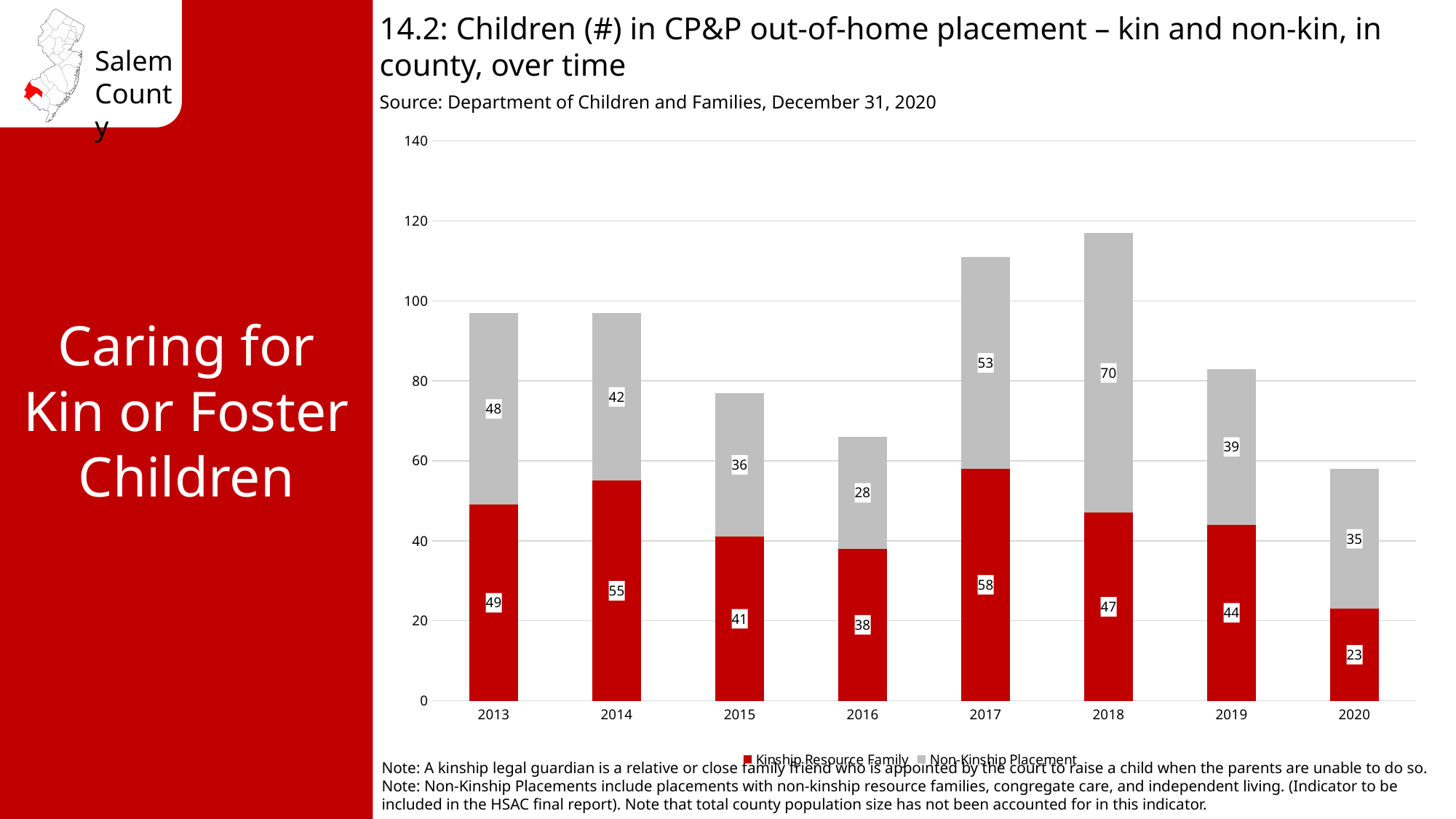
What is the difference between the Kinship Resource Family values for 2014 and 2015? 14 How many years are shown on the x axis? 8 Which year has the lowest Kinship Resource Family value? 2020 What is the Kinship Resource Family value for 2017? 58 Which year has the highest Non-Kinship Placement value? 2018 What is the total number of children in out-of-home placement in 2020? 58 What is the total number of children in out-of-home placement in 2018? 117 What is the Non-Kinship Placement value for 2018? 70 What is the Kinship Resource Family value for 2020? 23 How many series does the legend list? 2 Which is larger in 2016: the Kinship Resource Family value or the Non-Kinship Placement value? Kinship Resource Family What kind of chart is shown on the slide? Stacked bar chart